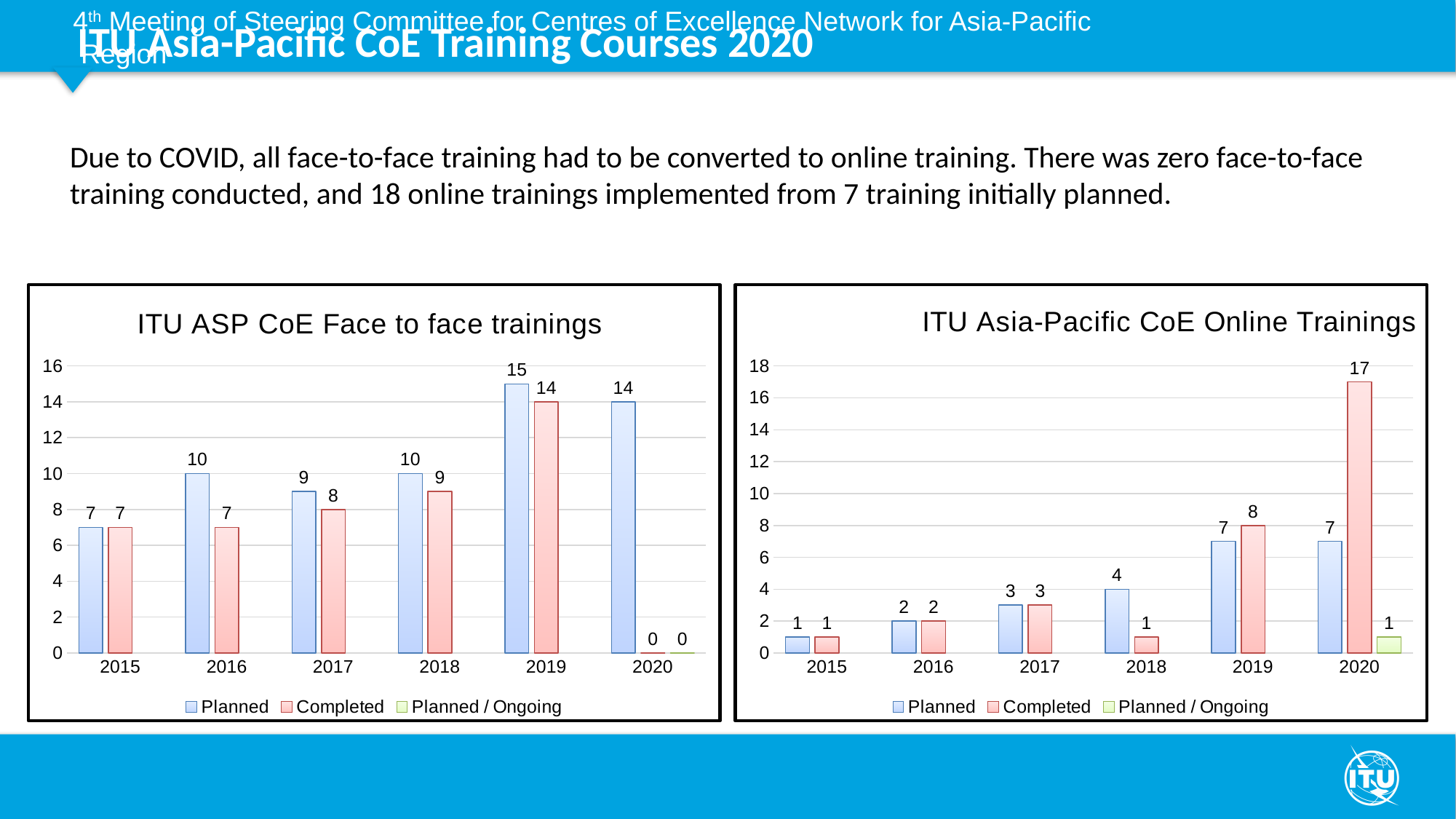
In the 'ITU Asia-Pacific CoE Online Trainings' chart, what is the Completed value for 2020? 17 In the 'ITU ASP CoE Face to face trainings' chart, how many years are shown on the x axis? 6 What type of chart is the 'ITU ASP CoE Face to face trainings' chart? Bar chart How many series does the legend of the 'ITU Asia-Pacific CoE Online Trainings' chart list? 3 In the 'ITU ASP CoE Face to face trainings' chart, what is the Completed value for 2018? 9 In the 'ITU ASP CoE Face to face trainings' chart, what is the difference between Planned and Completed in 2016? 3 In the 'ITU Asia-Pacific CoE Online Trainings' chart, is the Completed value for 2019 larger or smaller than the Planned value for 2019? larger In the 'ITU ASP CoE Face to face trainings' chart, which year has the highest Completed value? 2019 In the 'ITU Asia-Pacific CoE Online Trainings' chart, what is the Planned value for 2018? 4 In the 'ITU Asia-Pacific CoE Online Trainings' chart, what is the difference between Completed and Planned in 2020? 10 In the 'ITU Asia-Pacific CoE Online Trainings' chart, which year has the lowest Planned value? 2015 In the 'ITU ASP CoE Face to face trainings' chart, what is the Planned value for 2019? 15